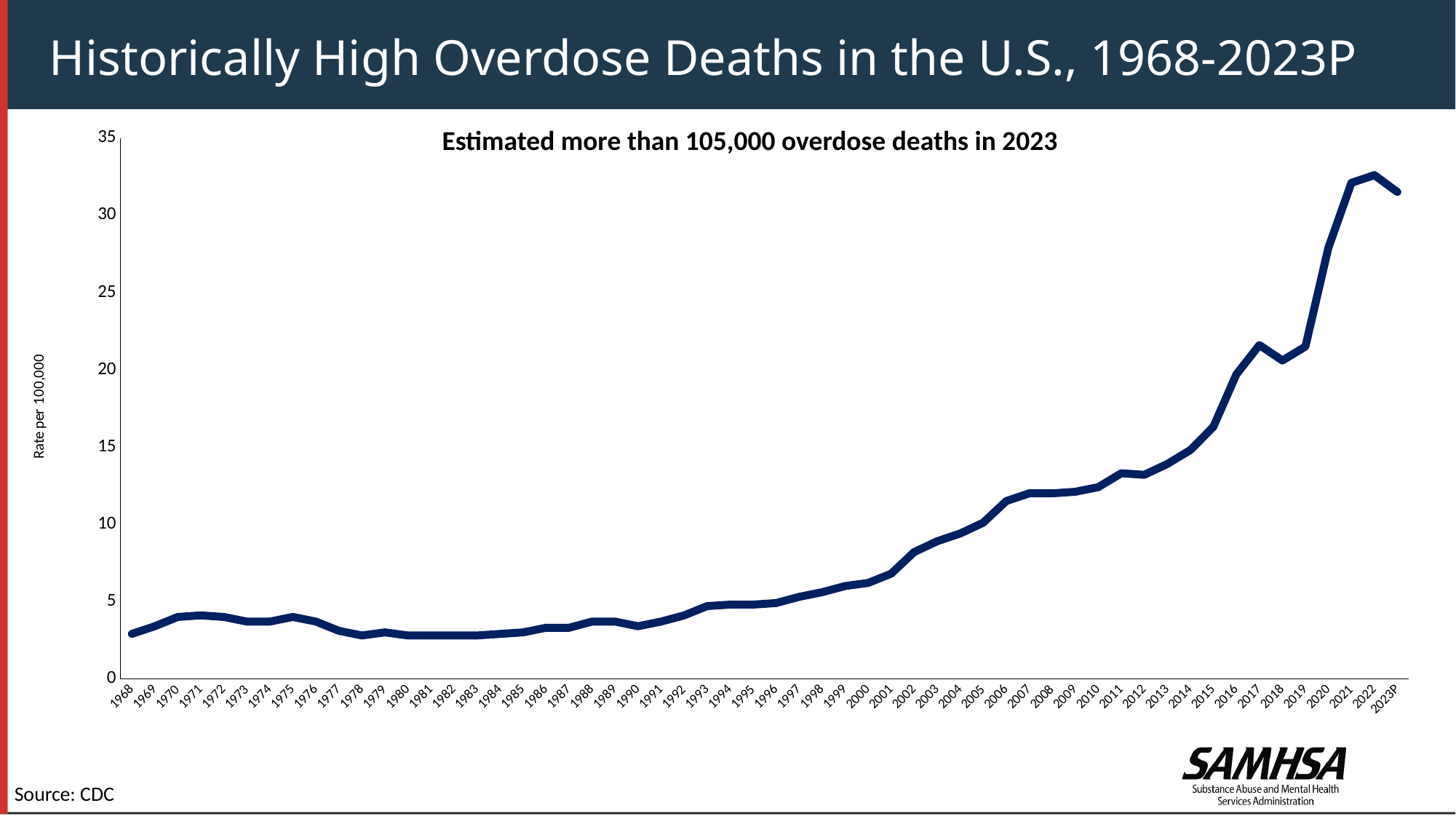
How many years are plotted on the x axis? 56 Which is higher, the value for 2022 or the value for 2023P? 2022 Is the value for 2017 greater or less than 20? greater Overall, do the values rise or fall from 1968 to 2023P? rise What is the label on the y axis? Rate per 100,000 Is the value for 2013 greater or less than 15? less Is the value for 1978 greater or less than 5? less Which is higher, the value for 2017 or the value for 2018? 2017 Which year has the highest overdose death rate on the chart? 2022 What kind of chart is shown on the slide? line chart